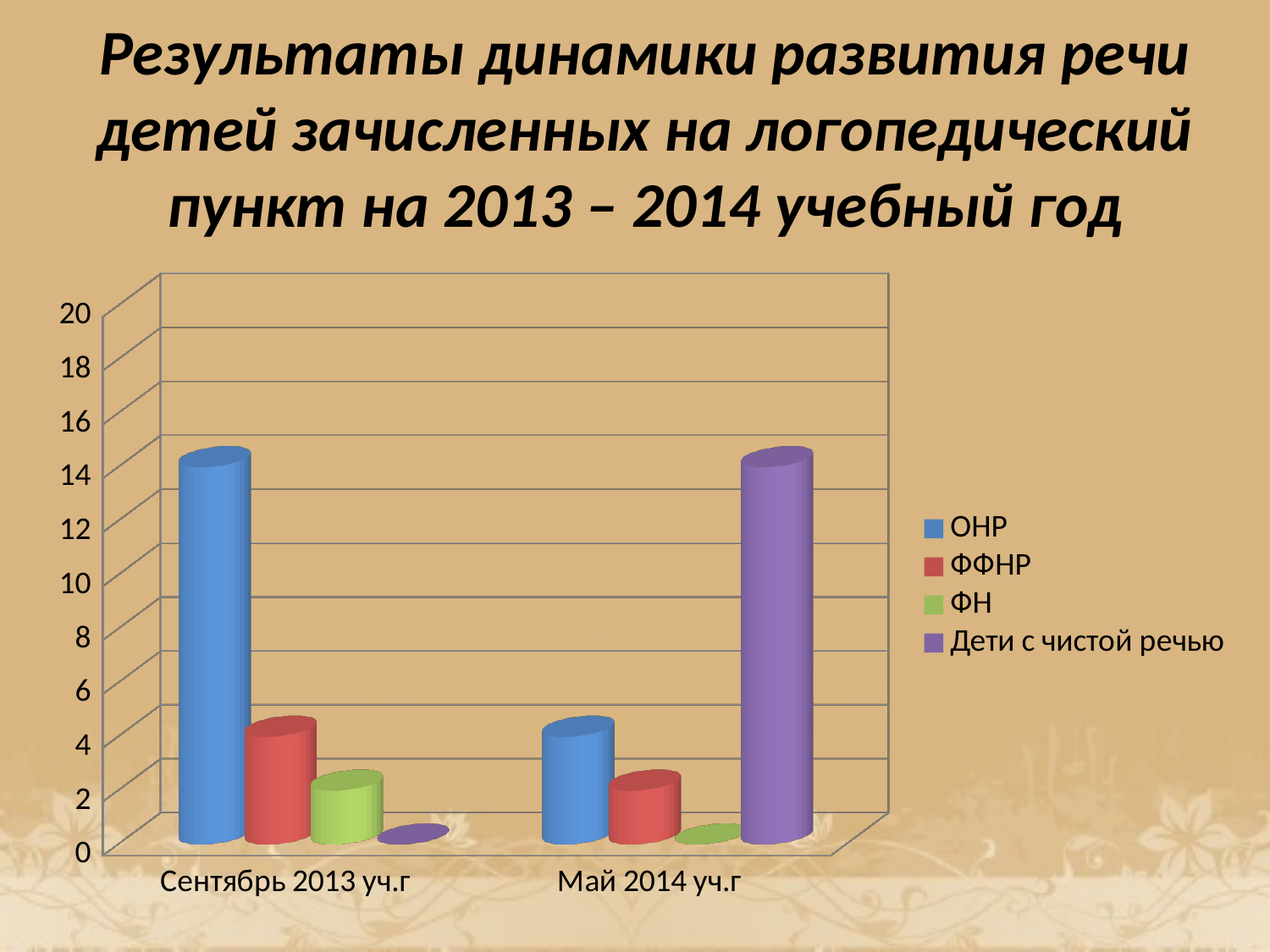
Which series has the lowest value for Май 2014 уч.г? ФН What kind of chart is shown on the slide? bar chart Is the value for ОНР in Сентябрь 2013 уч.г greater or less than 10? greater How many categories are shown on the x axis? 2 Is the value for ОНР in Май 2014 уч.г greater or less than 10? less Which series has the highest value for Май 2014 уч.г? Дети с чистой речью Which is larger: ФФНР in Сентябрь 2013 уч.г or ФФНР in Май 2014 уч.г? Сентябрь 2013 уч.г Does the value for ОНР rise or fall from Сентябрь 2013 уч.г to Май 2014 уч.г? fall How many series does the legend list? 4 Which series has the highest value for Сентябрь 2013 уч.г? ОНР Which series has the lowest value for Сентябрь 2013 уч.г? Дети с чистой речью Is the value for Дети с чистой речью in Май 2014 уч.г greater or less than 12? greater